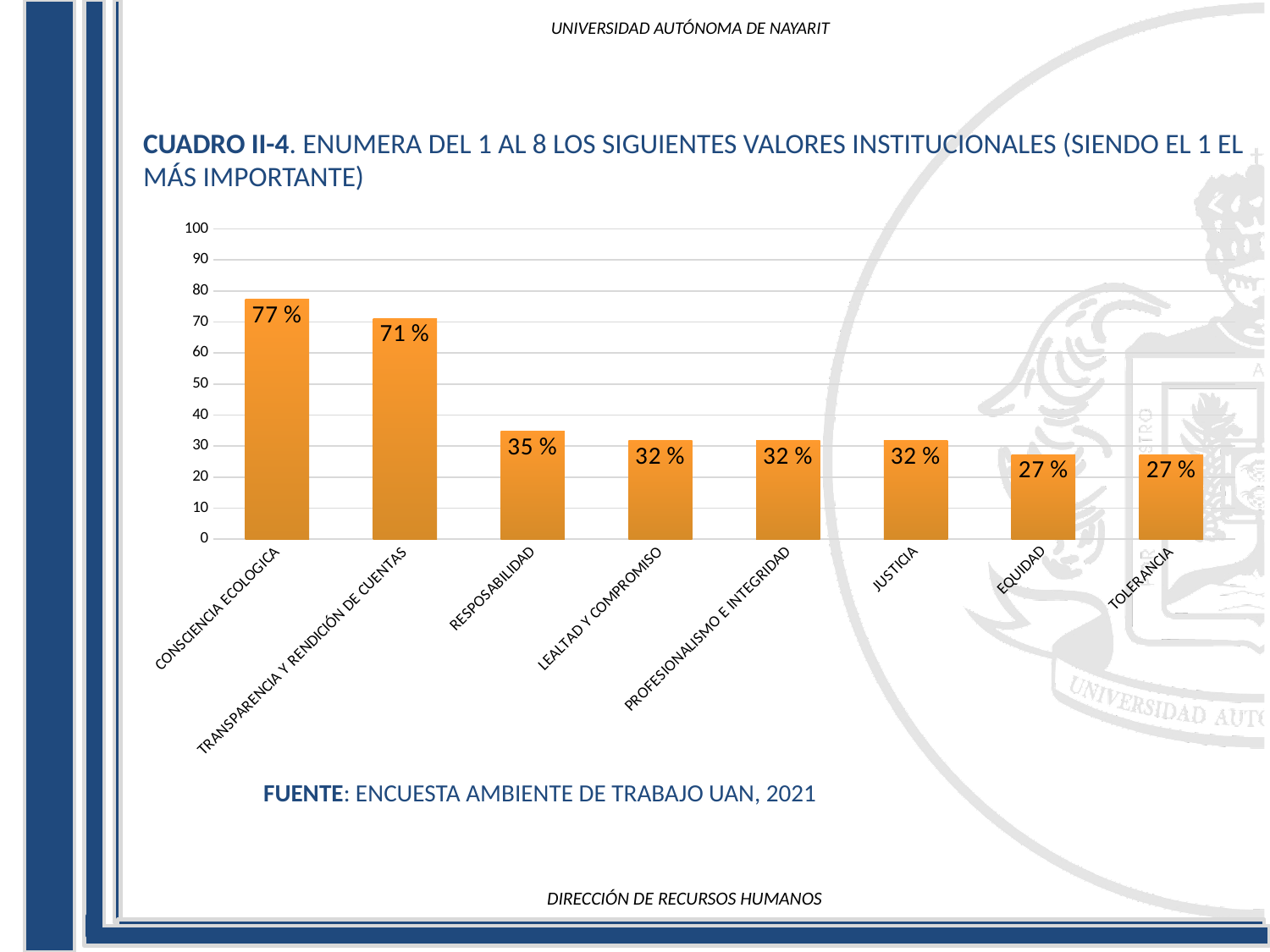
What is the difference between the values for CONSCIENCIA ECOLOGICA and TRANSPARENCIA Y RENDICIÓN DE CUENTAS? 6 % What is the value for TRANSPARENCIA Y RENDICIÓN DE CUENTAS? 71 % What is the source cited below the chart? ENCUESTA AMBIENTE DE TRABAJO UAN, 2021 What kind of chart is shown on the slide? bar chart Which is larger, the value for RESPOSABILIDAD or the value for EQUIDAD? RESPOSABILIDAD What is the value for JUSTICIA? 32 % Which category has the highest value? CONSCIENCIA ECOLOGICA What is the value for RESPOSABILIDAD? 35 % What is the value for CONSCIENCIA ECOLOGICA? 77 % Is the value for LEALTAD Y COMPROMISO greater or less than 40? less How many categories are shown on the x axis? 8 What is the value for TOLERANCIA? 27 %